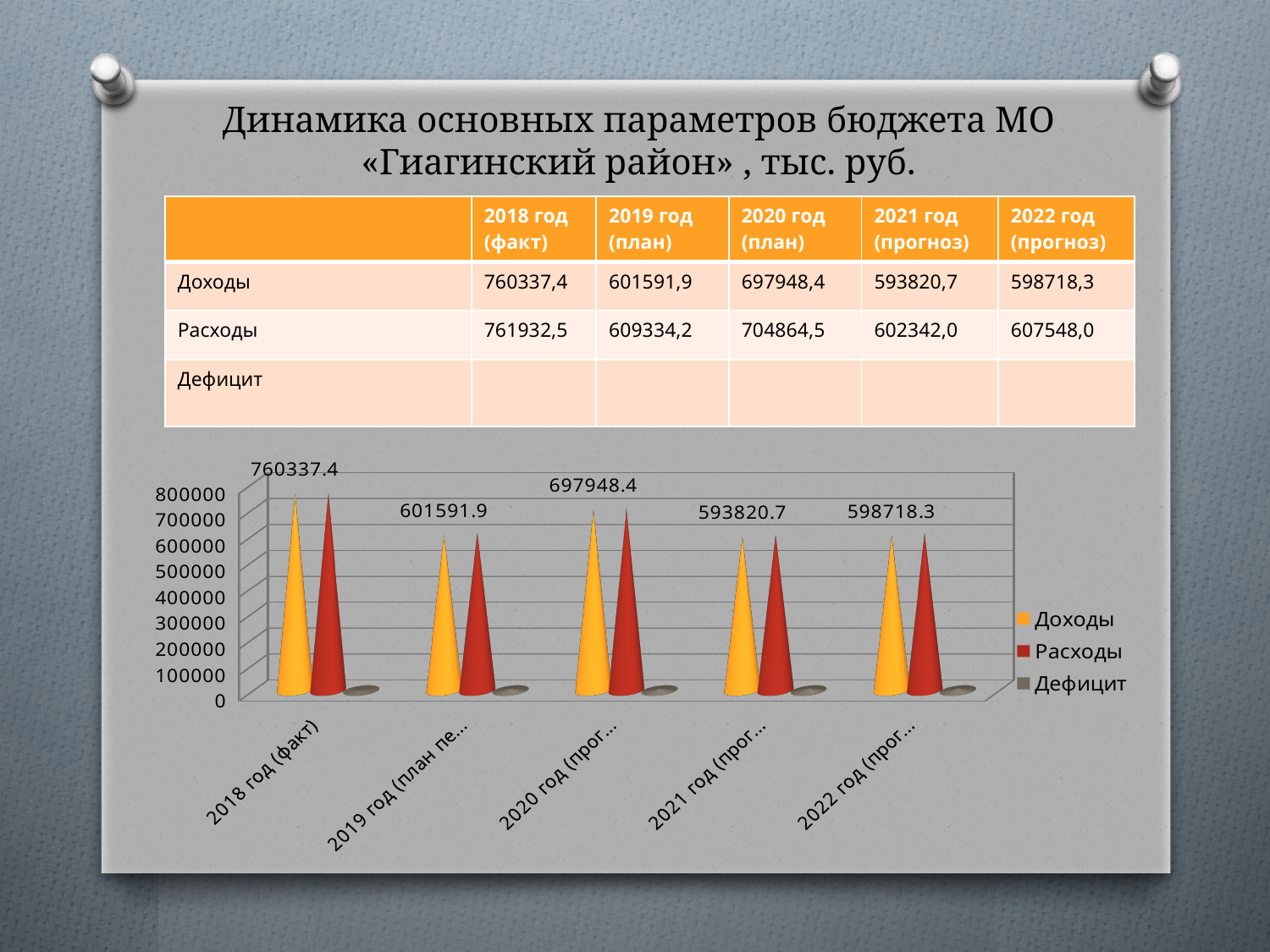
What is the value of Доходы for 2020 год in the chart? 697948.4 What is the value of Доходы for 2019 год in the chart? 601591.9 Which is larger in the chart: Доходы for 2021 год or for 2022 год? 2022 год Is the value of Расходы for 2018 год (факт) in the chart greater or less than 700000? greater What is the value of Доходы for 2022 год in the chart? 598718.3 In which year is Доходы lowest in the chart? 2021 год What is the difference between Доходы in 2018 год (факт) and 2019 год in the chart? 158745.5 In which year is Доходы highest in the chart? 2018 год (факт) How many year categories are shown on the x axis of the chart? 5 What kind of chart is shown on the slide? bar chart How many series does the chart legend list? 3 What is the value of Доходы for 2018 год (факт) in the chart? 760337.4